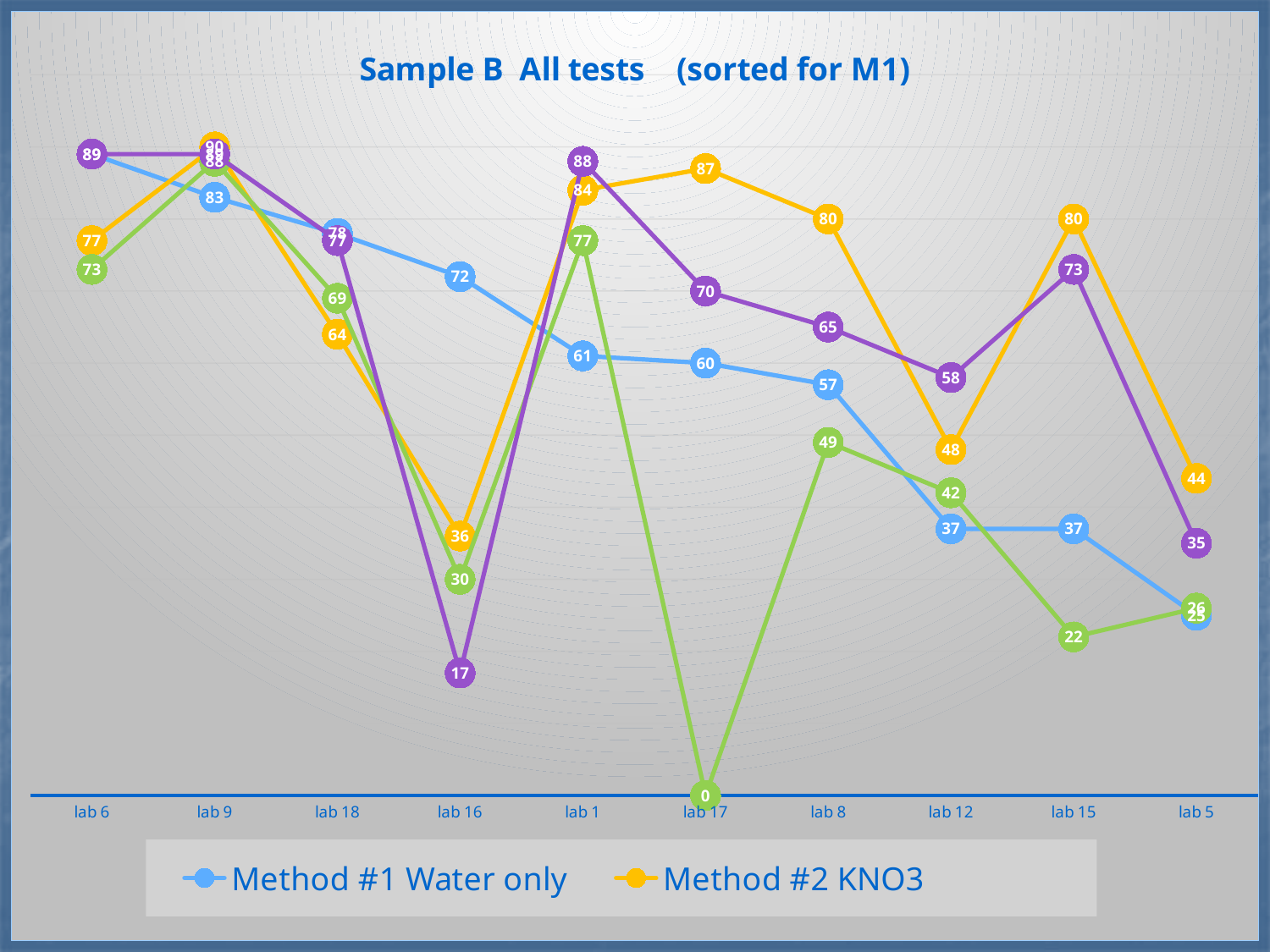
Which lab has the lowest value for Method #2 KNO3? lab 16 What is the value for Method #1 Water only at lab 16? 72 What is the difference between the Method #2 KNO3 values at lab 17 and lab 16? 51 How many labs are shown on the x axis? 10 At lab 17, which series has the higher value, Method #1 Water only or Method #2 KNO3? Method #2 KNO3 What is the value for Method #1 Water only at lab 9? 83 What kind of chart is this? line chart What is the value for Method #1 Water only at lab 17? 60 What is the value for Method #2 KNO3 at lab 5? 44 What is the value for Method #2 KNO3 at lab 17? 87 How many series does the legend list? 2 What is the value for Method #2 KNO3 at lab 6? 77